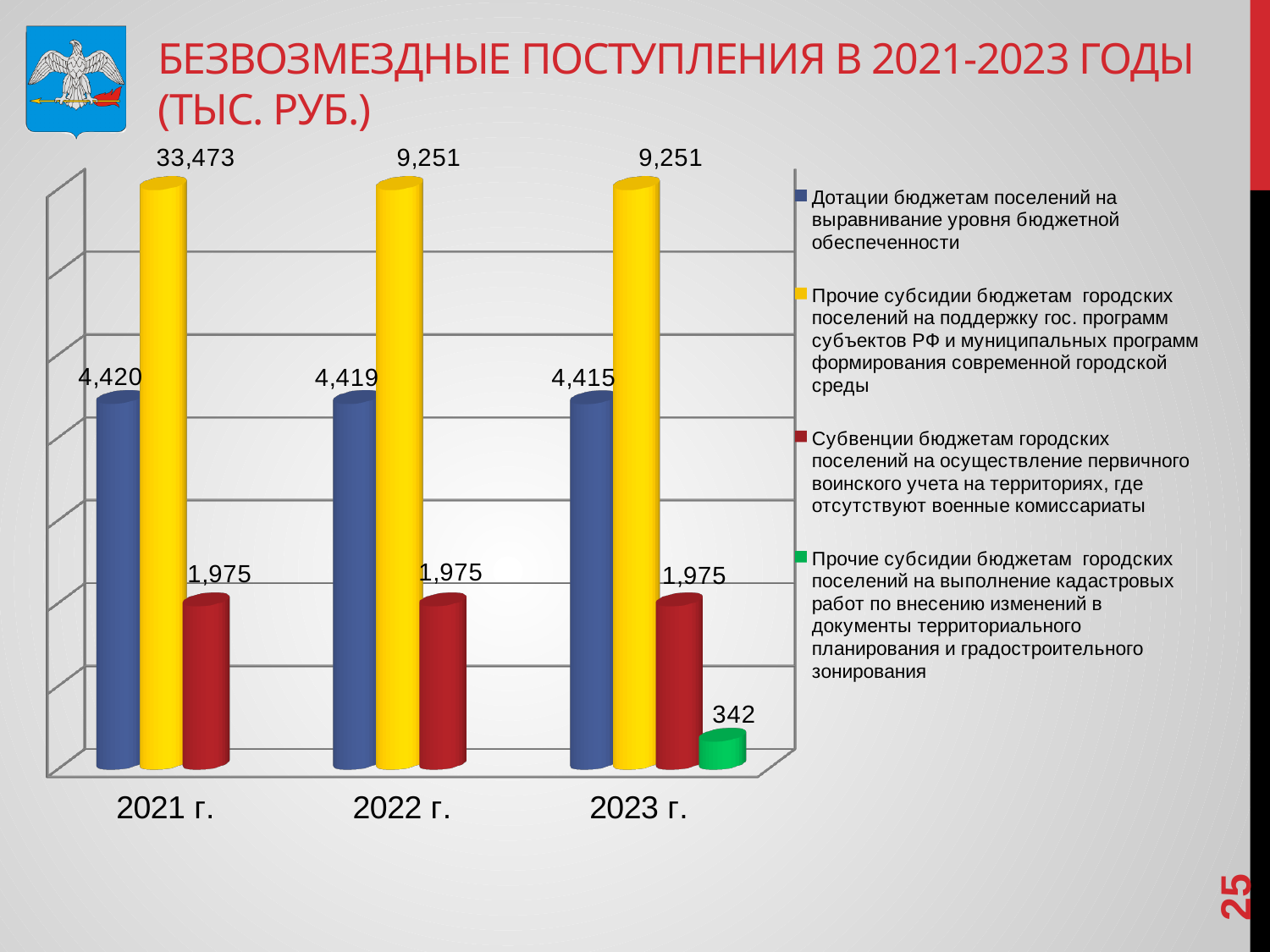
What is the value of the green series (Прочие субсидии ... кадастровых работ) for 2023 г.? 342 What is the value of the yellow series (Прочие субсидии ... формирования современной городской среды) for 2021 г.? 33,473 What kind of chart is shown on the slide? Bar chart Which is larger in 2023 г.: the blue series (Дотации) or the yellow series (Прочие субсидии ... городской среды)? Yellow series (9,251) In which year is the blue series (Дотации бюджетам поселений) lowest? 2023 г. How many years (categories) are shown on the x axis? 3 What is the difference between the blue series value and the red series value in 2021 г.? 2,445 What is the value of the red series (Субвенции бюджетам городских поселений ...) for 2022 г.? 1,975 How many series does the legend list? 4 What is the difference between the yellow series value in 2021 г. and in 2022 г.? 24,222 In which year is the yellow series (Прочие субсидии ... городской среды) highest? 2021 г. What is the value of the blue series (Дотации бюджетам поселений на выравнивание уровня бюджетной обеспеченности) for 2023 г.? 4,415